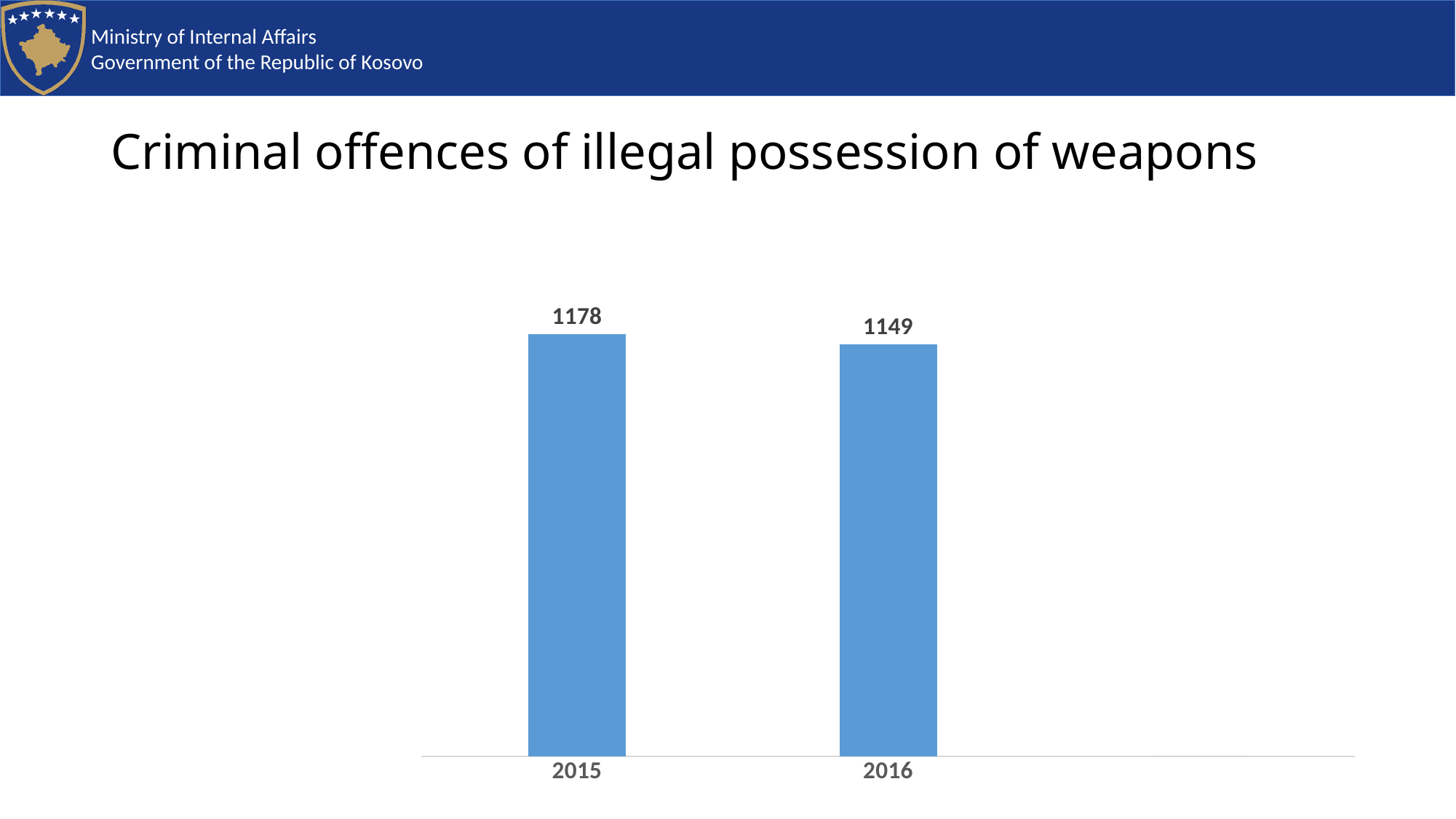
What is the value for 2016? 1149 What kind of chart is shown on the slide? Bar chart Which is larger, the value for 2015 or the value for 2016? 2015 Which year has the highest value? 2015 Do the values rise or fall from 2015 to 2016? Fall What is the value for 2015? 1178 What colour are the bars in the chart? Blue How many years are shown on the chart? 2 What is the difference between the values for 2015 and 2016? 29 What is the title of the slide? Criminal offences of illegal possession of weapons Which year has the lowest value? 2016